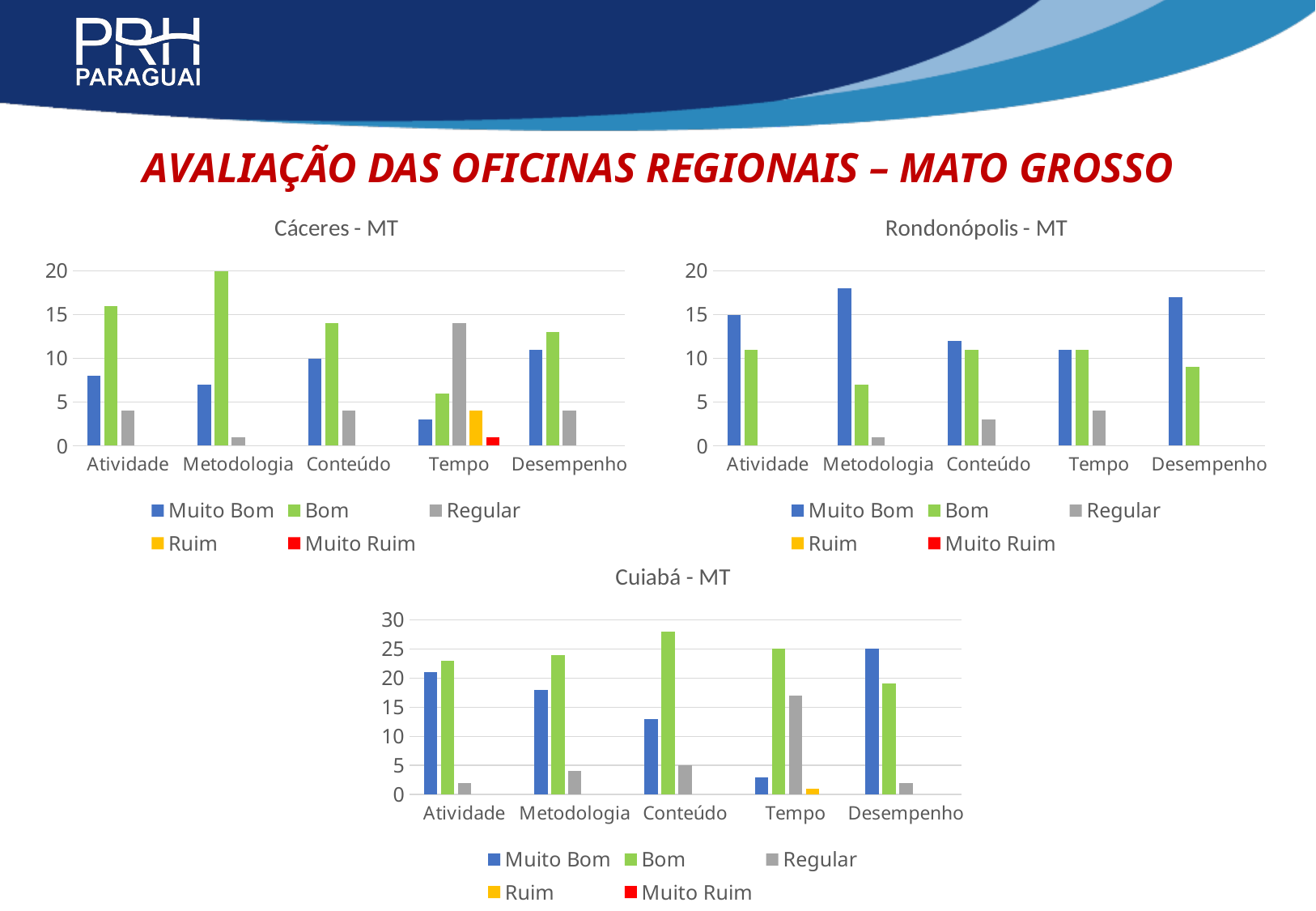
Which chart on the slide has a y axis that goes up to 30? Cuiabá - MT In the Cáceres - MT chart, is the Regular value for Tempo greater or less than 10? greater In the Rondonópolis - MT chart, is the Muito Bom value for Desempenho greater or less than 15? greater In the Rondonópolis - MT chart, which category has the highest Muito Bom value? Metodologia In the Cáceres - MT chart, which category has the lowest Muito Bom value? Tempo How many series does the legend of the Cuiabá - MT chart list? 5 What kind of chart is the Cáceres - MT chart? bar chart In the Cáceres - MT chart, which category has the highest Bom value? Metodologia In the Cuiabá - MT chart, which is larger for Tempo: Muito Bom or Regular? Regular In the Cuiabá - MT chart, which category has the highest Bom value? Conteúdo How many categories are shown on the x axis of the Rondonópolis - MT chart? 5 In the Cáceres - MT chart, what is the Bom value for Metodologia? 20